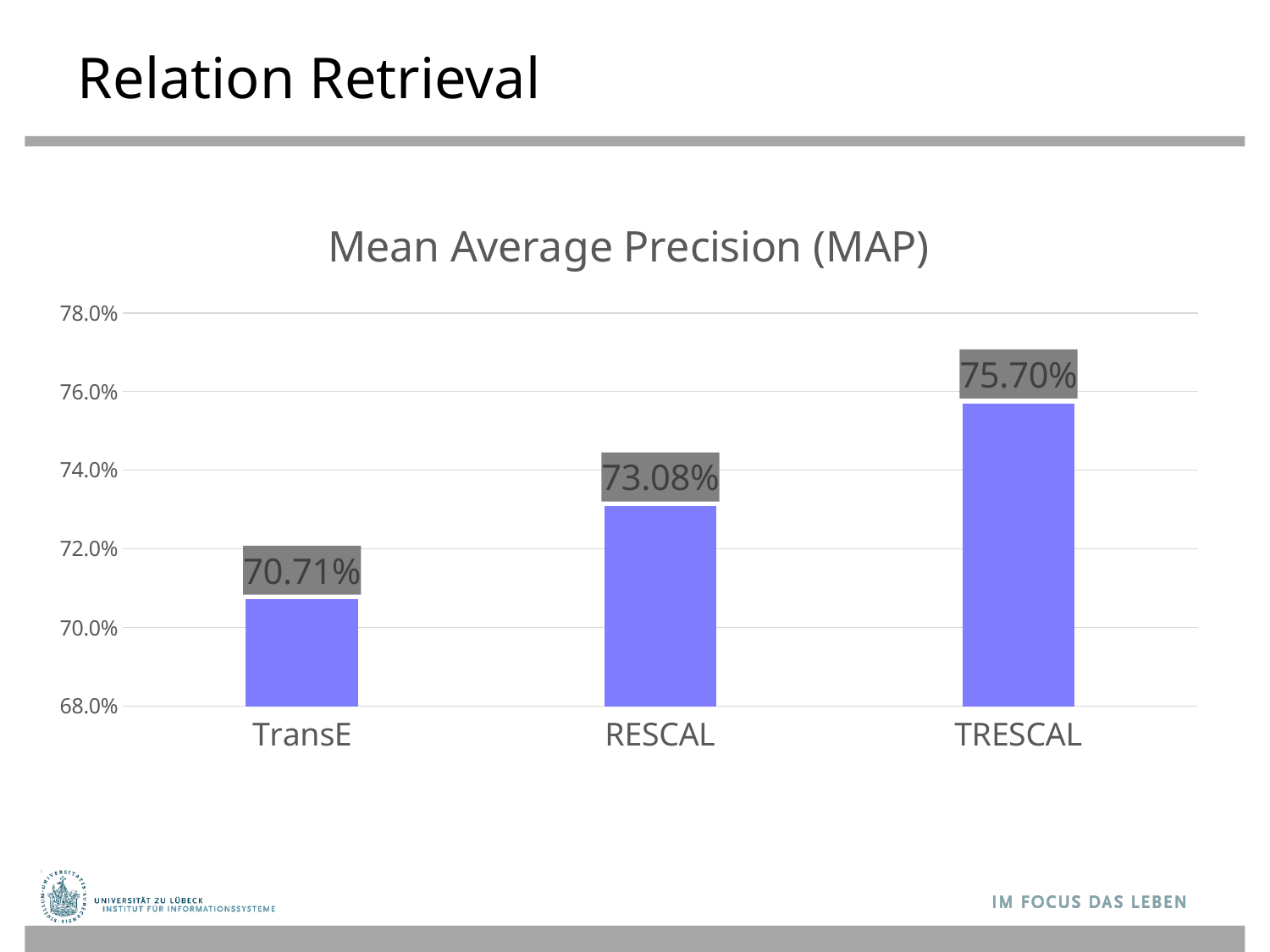
What is the difference in MAP between RESCAL and TransE? 2.37% What is the Mean Average Precision (MAP) value for TRESCAL? 75.70% What kind of chart is shown on the slide? bar chart Do the MAP values rise or fall from TransE to TRESCAL along the x axis? rise What is the Mean Average Precision (MAP) value for TransE? 70.71% How many methods are compared in the chart? 3 What is the Mean Average Precision (MAP) value for RESCAL? 73.08% Is the MAP value for RESCAL greater or less than 74.0%? less Which has a higher MAP, RESCAL or TRESCAL? TRESCAL Which method has the lowest Mean Average Precision (MAP)? TransE Which method has the highest Mean Average Precision (MAP)? TRESCAL What is the difference in MAP between TRESCAL and TransE? 4.99%